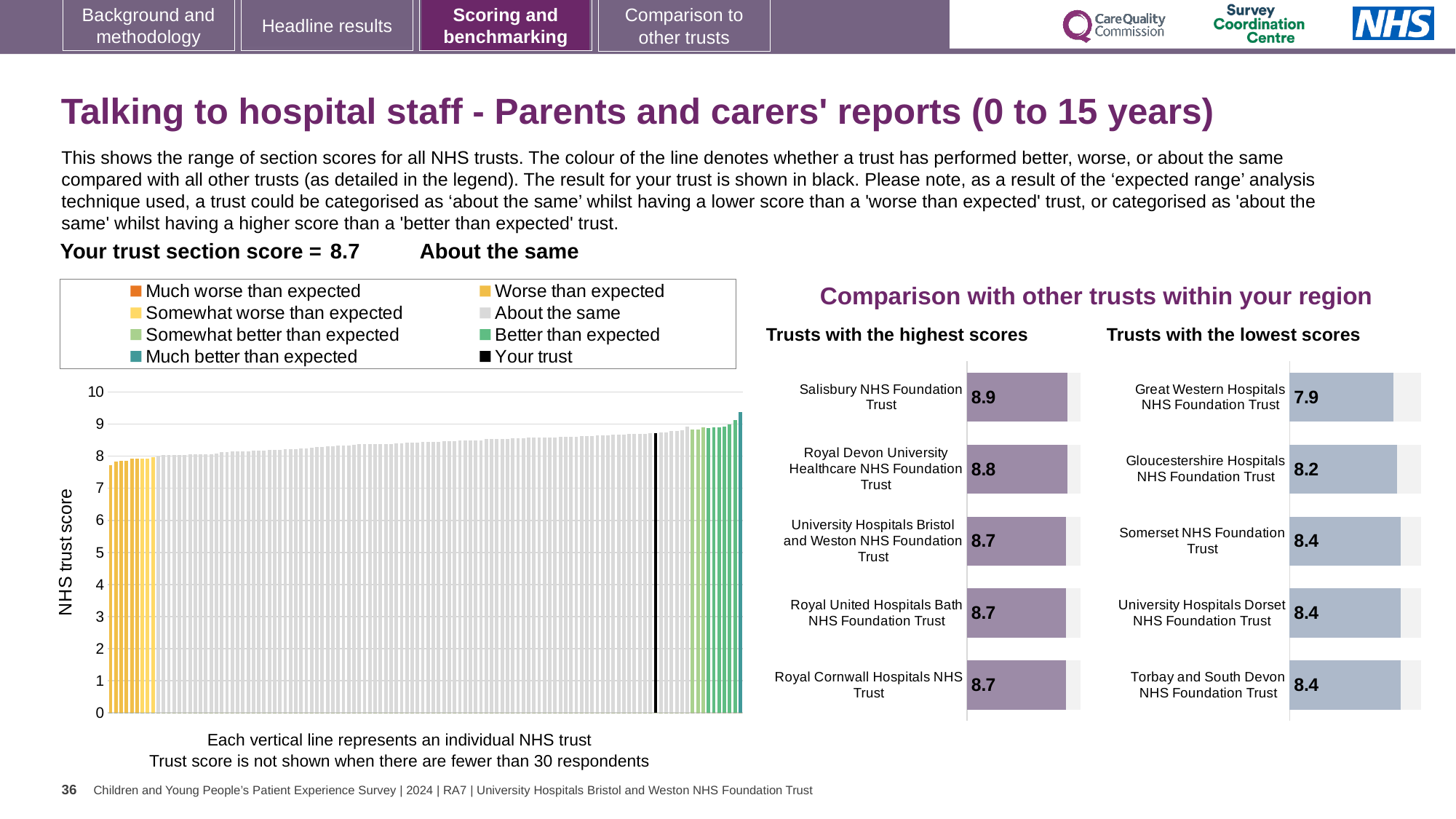
In the 'Trusts with the highest scores' chart, what is the score for Salisbury NHS Foundation Trust? 8.9 How many entries does the legend of the 'NHS trust score' chart list? 8 How many trusts are listed in the 'Trusts with the lowest scores' chart? 5 In the 'Trusts with the lowest scores' chart, what is the score for Great Western Hospitals NHS Foundation Trust? 7.9 In the 'Trusts with the lowest scores' chart, which trust has the lowest score? Great Western Hospitals NHS Foundation Trust In the 'NHS trust score' chart, is the value for the black 'Your trust' bar greater or less than 8? greater What kind of chart is the 'NHS trust score' chart on the left of the slide? Bar chart In the 'Trusts with the highest scores' chart, which has the larger score: Salisbury NHS Foundation Trust or Royal Devon University Healthcare NHS Foundation Trust? Salisbury NHS Foundation Trust In the 'Trusts with the lowest scores' chart, what is the difference between the scores for Gloucestershire Hospitals NHS Foundation Trust and Great Western Hospitals NHS Foundation Trust? 0.3 In the 'NHS trust score' chart, do the bar values rise or fall from left to right along the x axis? Rise What is the difference between the score for Salisbury NHS Foundation Trust in the 'Trusts with the highest scores' chart and the score for Great Western Hospitals NHS Foundation Trust in the 'Trusts with the lowest scores' chart? 1.0 In the 'Trusts with the highest scores' chart, which trust has the highest score? Salisbury NHS Foundation Trust